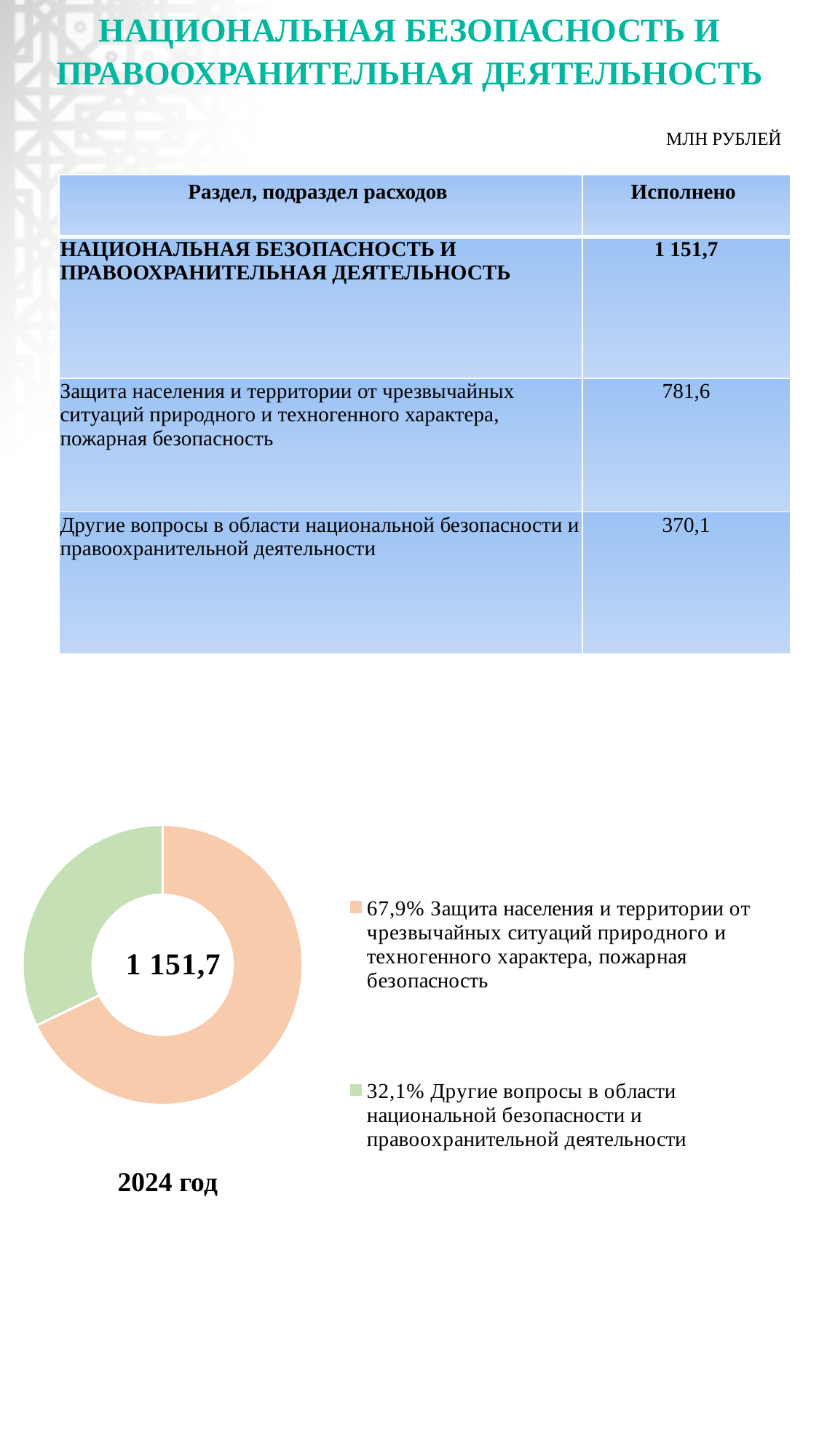
What is the difference in percentage points between the two slices of the doughnut chart? 35,8 How many entries does the legend of the doughnut chart list? 2 Which is larger in the doughnut chart: the share for "Защита населения..." or the share for "Другие вопросы..."? Защита населения и территории от чрезвычайных ситуаций природного и техногенного характера, пожарная безопасность Which slice of the doughnut chart is the largest? Защита населения и территории от чрезвычайных ситуаций природного и техногенного характера, пожарная безопасность What kind of chart is shown on the slide? Doughnut (pie) chart How many slices does the doughnut chart have? 2 What share of the doughnut chart is taken by "Защита населения и территории от чрезвычайных ситуаций природного и техногенного характера, пожарная безопасность"? 67,9% What share of the doughnut chart is taken by "Другие вопросы в области национальной безопасности и правоохранительной деятельности"? 32,1% What total value is printed in the centre of the doughnut chart? 1 151,7 Which slice of the doughnut chart is the smallest? Другие вопросы в области национальной безопасности и правоохранительной деятельности What colour is the slice for "Другие вопросы в области национальной безопасности и правоохранительной деятельности" in the doughnut chart? Green What year label is shown below the doughnut chart? 2024 год